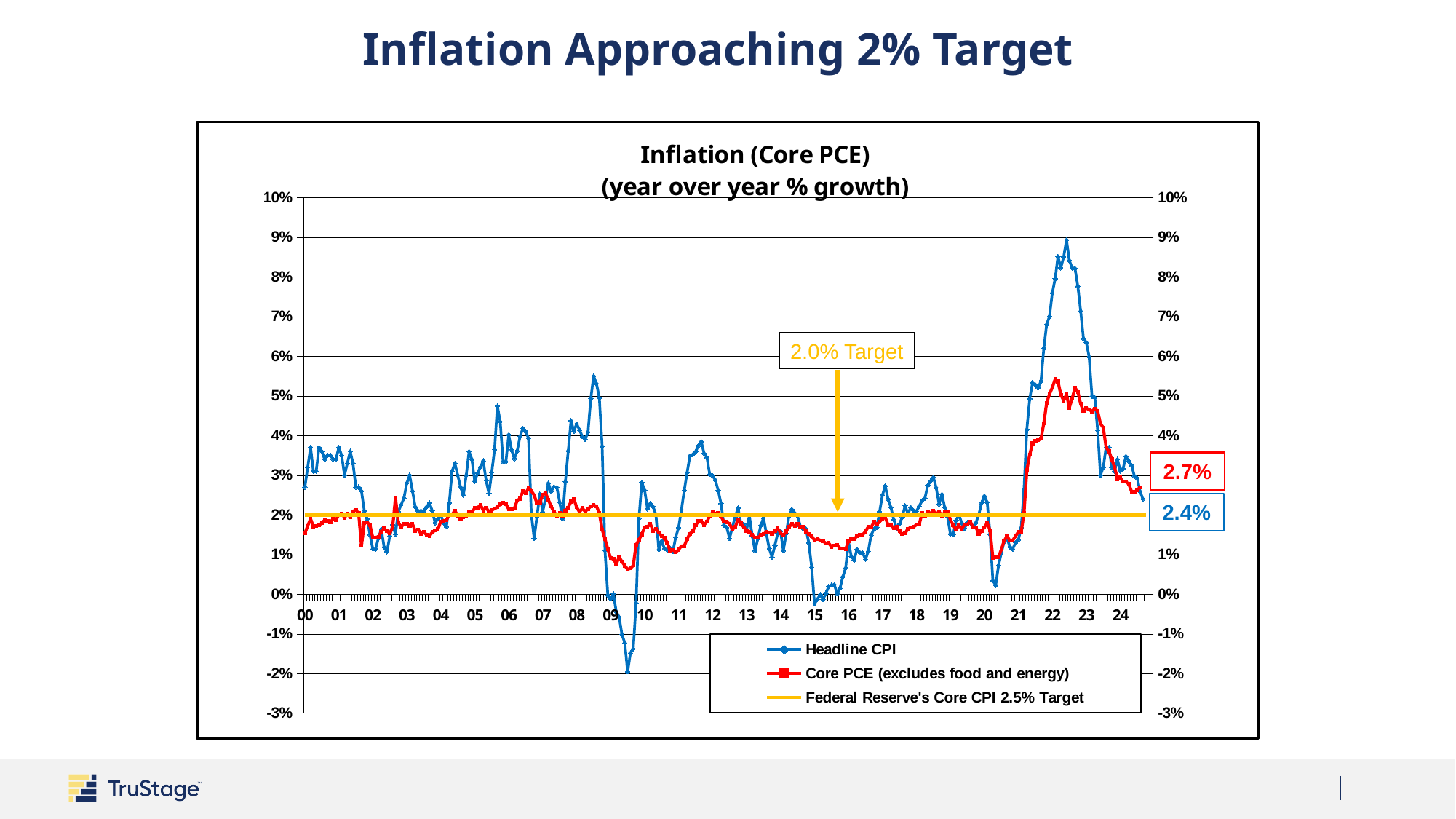
How many series does the legend list? 3 What is the latest Core PCE value labeled at the right edge of the chart? 2.7% What does the annotation with the arrow say the yellow horizontal line represents? 2.0% Target What is the latest Headline CPI value labeled at the right edge of the chart? 2.4% Which series reaches the highest peak on the chart? Headline CPI At the right edge of the chart, which is higher: the labeled Core PCE value or the labeled Headline CPI value? Core PCE Is the peak of Core PCE in 2022 greater or less than 5%? greater Is the lowest point of Headline CPI in 2009 greater or less than -1%? less What is the difference between the labeled latest Core PCE value (2.7%) and the labeled latest Headline CPI value (2.4%)? 0.3 percentage points What kind of chart is shown on the slide? Line chart From its 2022 peak to 2024, does Headline CPI rise or fall? Fall Is the peak of Headline CPI in 2022 greater or less than 8%? greater